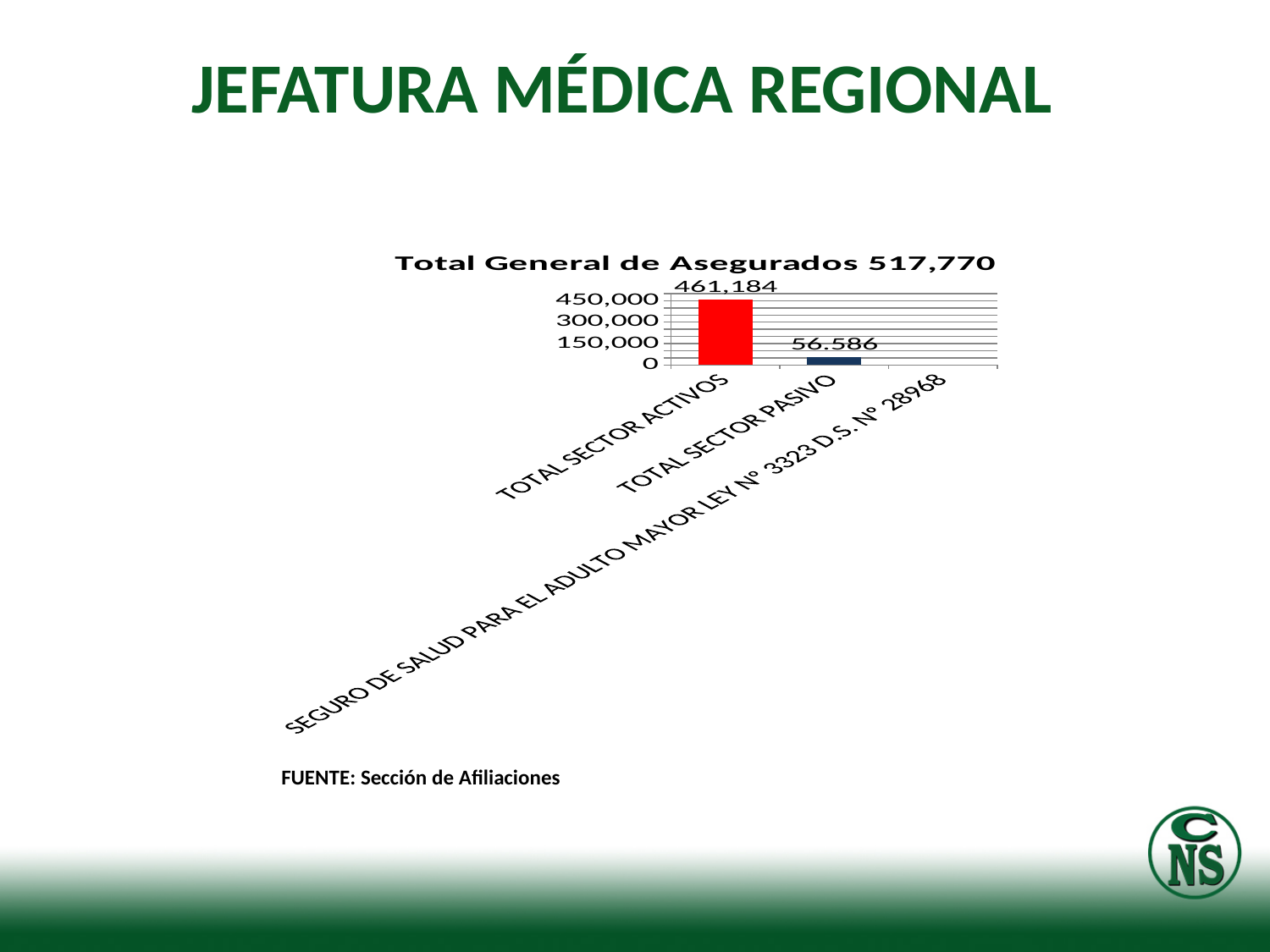
What is the value for TOTAL SECTOR PASIVO? 56.586 How many categories are shown on the x axis of the chart? 3 Which is larger, the value for TOTAL SECTOR ACTIVOS or TOTAL SECTOR PASIVO? TOTAL SECTOR ACTIVOS What colour is the bar for TOTAL SECTOR ACTIVOS? red What is the title of the chart? Total General de Asegurados 517,770 Is the value for TOTAL SECTOR PASIVO greater or less than 150,000? less What is the value for TOTAL SECTOR ACTIVOS? 461,184 What kind of chart is shown on the slide? bar chart Which category has the highest value? TOTAL SECTOR ACTIVOS Is the value for TOTAL SECTOR ACTIVOS greater or less than 450,000? greater